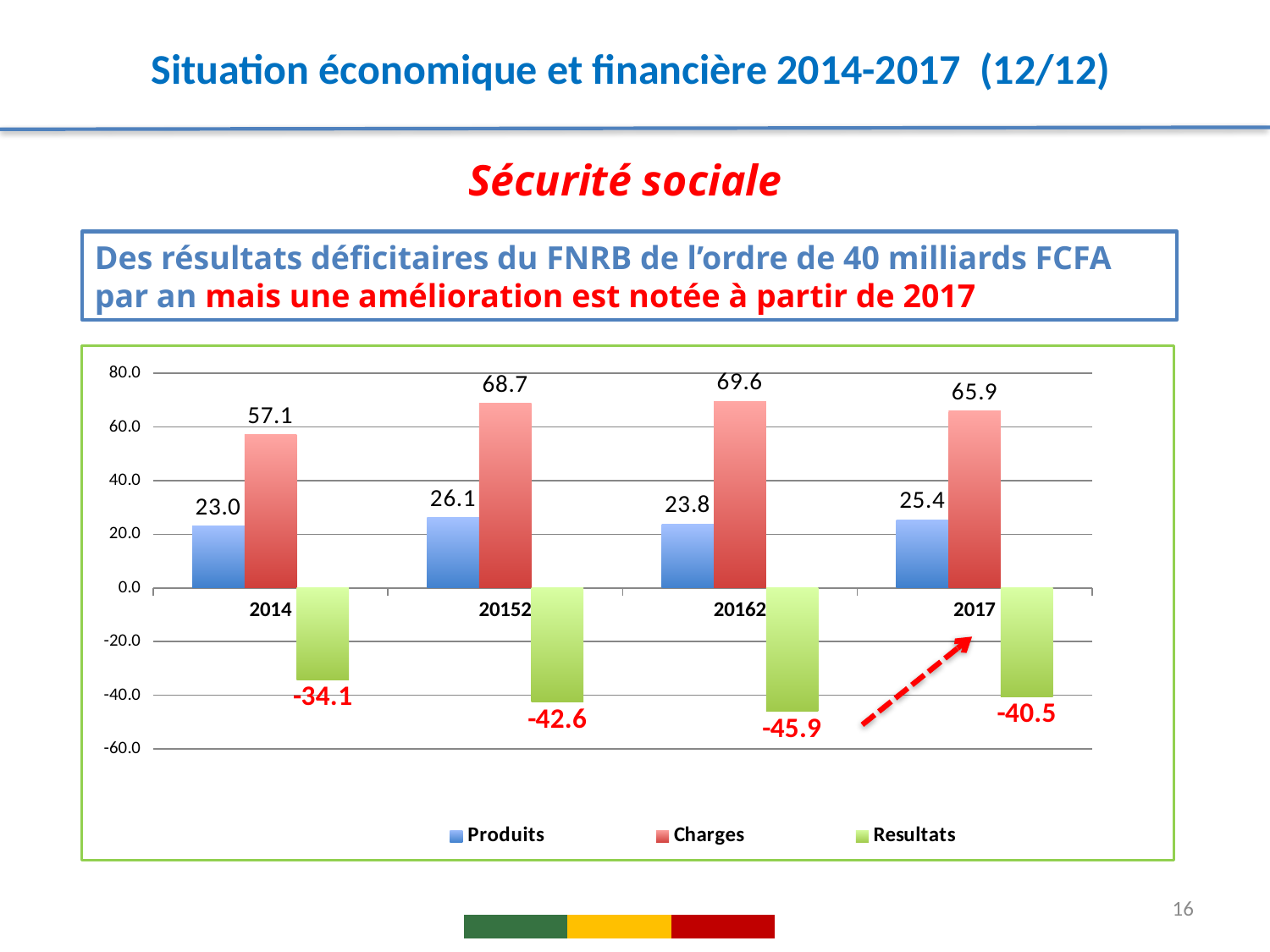
Which is larger, Produits in 20152 or Produits in 2014? Produits in 20152 What is the value of Resultats for the category labelled 20162? -45.9 Do the Charges values rise or fall from 2014 to 20162? Rise What is the value of Produits for 2017? 25.4 In which year are Charges highest? 20162 How many years are shown on the x axis? 4 What kind of chart is shown on the slide? Bar chart What is the value of Charges for 2014? 57.1 In which year is the Resultats value lowest (most negative)? 20162 How many series does the legend list? 3 Which colour represents the Resultats series in the legend? Green What is the difference between Charges and Produits in 2017? 40.5